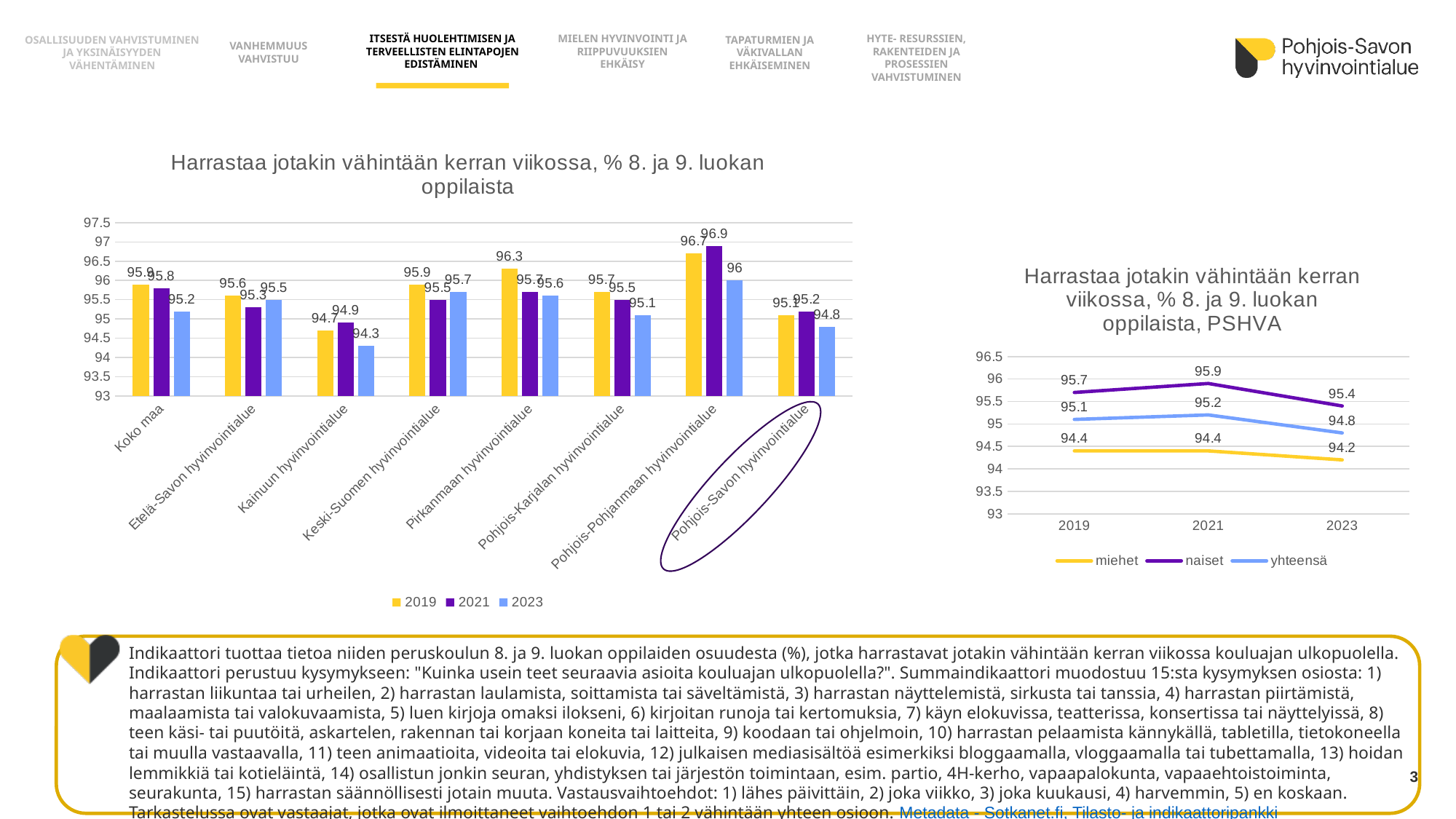
In the left bar chart, what is the 2019 value for Pirkanmaan hyvinvointialue? 96.3 How many regions (categories) are shown in the left bar chart? 8 In the left bar chart, what is the difference between the 2019 values for Koko maa and Pohjois-Savon hyvinvointialue? 0.8 In the right line chart, does the miehet series rise or fall from 2021 to 2023? fall In the right line chart, what is the difference between naiset and miehet in 2023? 1.2 In the left bar chart, which region has the highest 2021 value? Pohjois-Pohjanmaan hyvinvointialue In the right line chart, what is the value for naiset in 2021? 95.9 How many series does the legend of the left bar chart list? 3 In the left bar chart, what is the 2023 value for Pohjois-Savon hyvinvointialue? 94.8 What kind of chart is the chart on the right titled 'Harrastaa jotakin vähintään kerran viikossa, % 8. ja 9. luokan oppilaista, PSHVA'? line chart In the left bar chart, which region has the lowest 2023 value? Kainuun hyvinvointialue In the left bar chart, which is larger: the 2023 value for Keski-Suomen hyvinvointialue or the 2023 value for Pohjois-Karjalan hyvinvointialue? Keski-Suomen hyvinvointialue